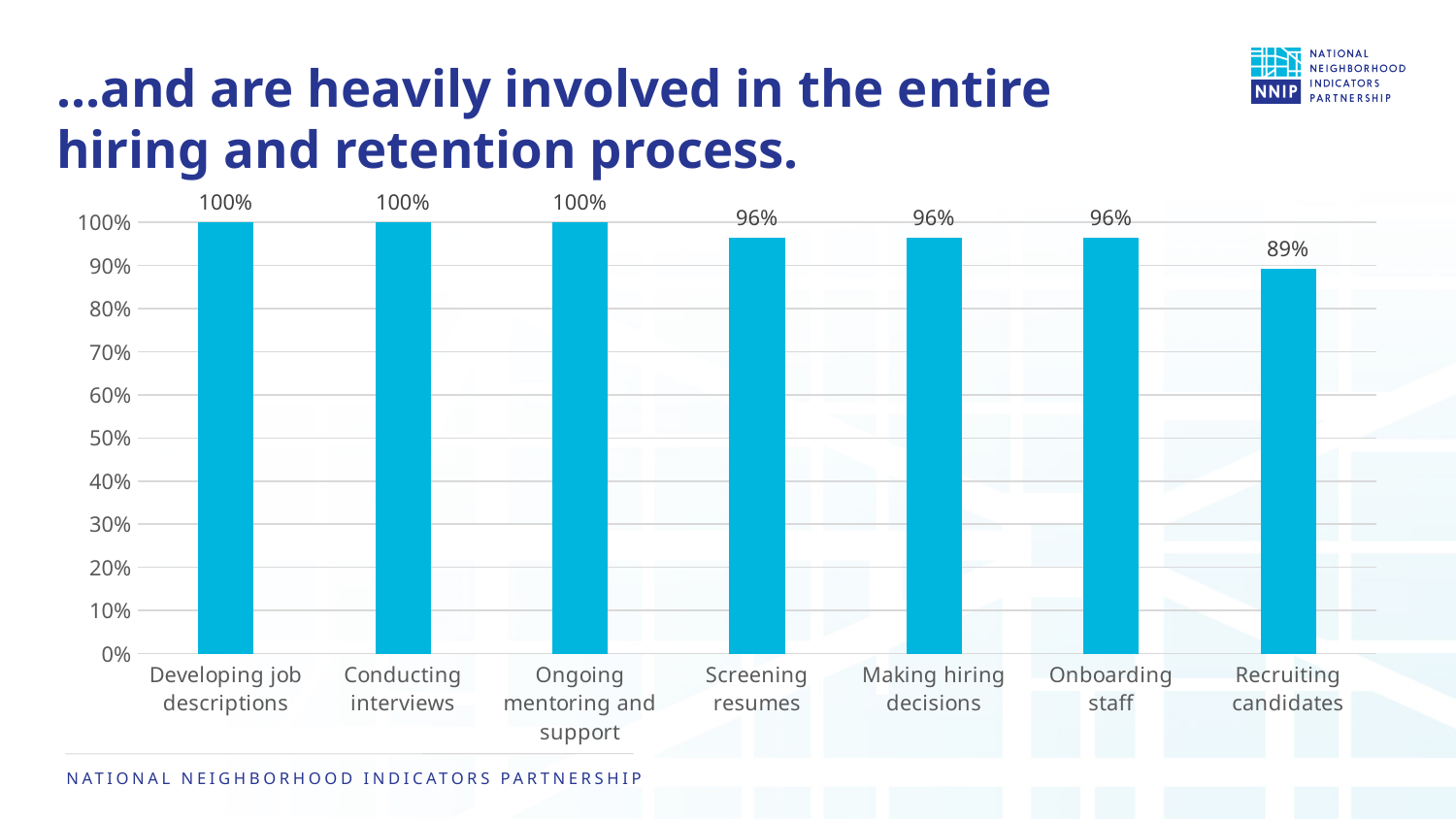
What is the difference between the values for Developing job descriptions and Recruiting candidates? 11% What is the difference between the values for Making hiring decisions and Recruiting candidates? 7% What is the value for Onboarding staff? 96% What is the highest value shown on the vertical axis? 100% How many categories have a value of 100%? 3 What is the value for Screening resumes? 96% What kind of chart is shown on the slide? Bar chart What is the value for Recruiting candidates? 89% What is the value for Conducting interviews? 100% Which is larger, the value for Ongoing mentoring and support or the value for Screening resumes? Ongoing mentoring and support Which category has the lowest value? Recruiting candidates How many categories are shown on the chart? 7